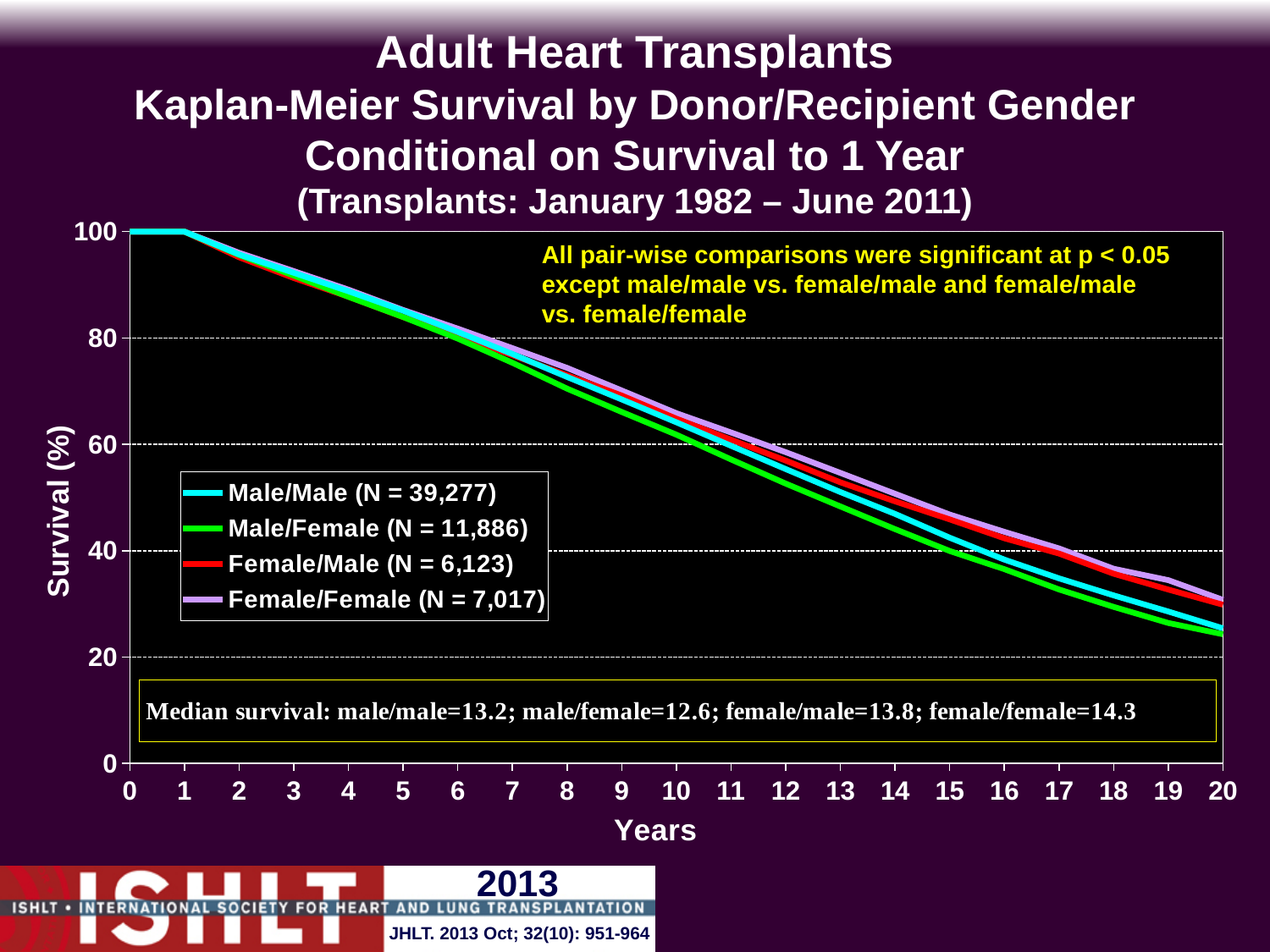
What is the median survival for female/female according to the text box? 14.3 Which donor/recipient group has the lowest median survival? male/female Which donor/recipient group has the highest median survival? female/female What kind of chart is shown on the slide? line chart Is the Male/Female survival value at year 20 greater or less than 40? less What is the difference between the female/female and male/female median survival values? 1.7 What is the N for the Male/Male series in the legend? 39,277 Do the survival curves rise or fall as years increase? fall How many series does the legend list? 4 What is the N for the Female/Female series in the legend? 7,017 At year 20, which is larger: the Female/Female survival or the Male/Female survival? Female/Female What is the median survival for male/female according to the text box? 12.6